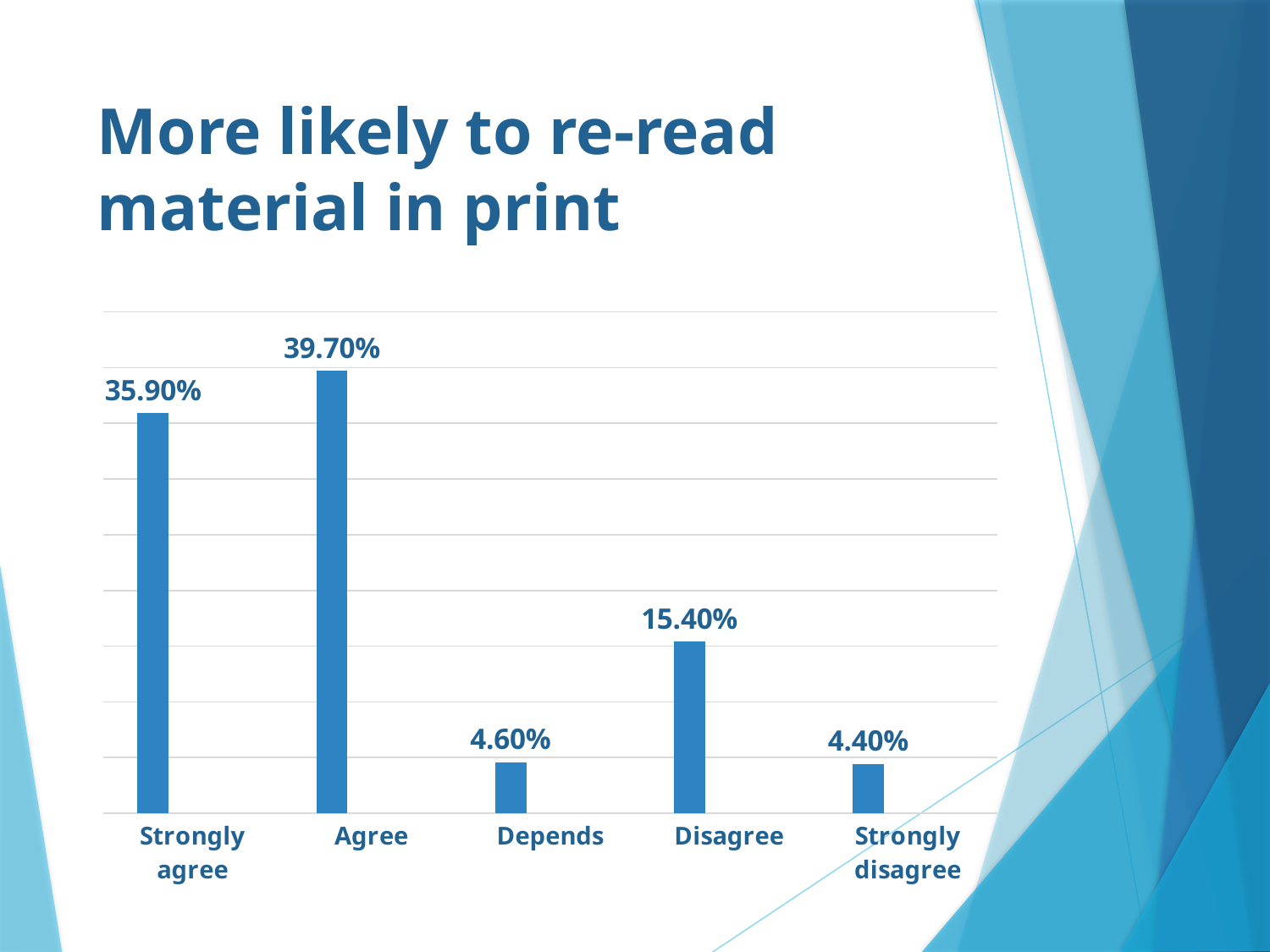
What is the difference between the values for Agree and Strongly agree? 3.80% Which is larger, the value for Disagree or the value for Depends? Disagree Which category has the highest value? Agree What kind of chart is shown on the slide? Bar chart How many categories are shown on the x axis? 5 What is the value for Strongly agree? 35.90% What is the value for Agree? 39.70% What is the difference between the values for Disagree and Depends? 10.80% What is the value for Depends? 4.60% What is the title of the slide? More likely to re-read material in print What is the value for Disagree? 15.40% What is the value for Strongly disagree? 4.40%